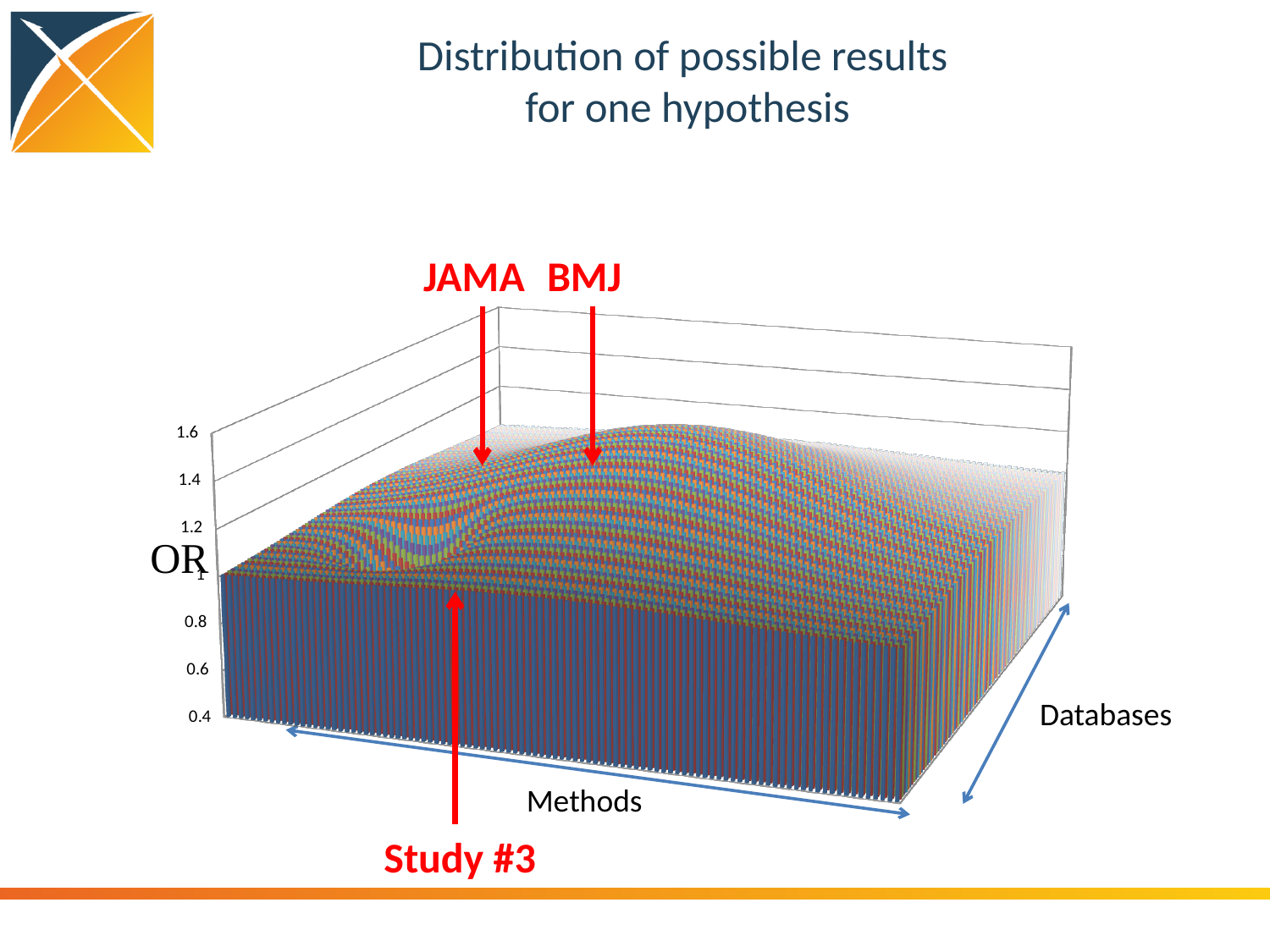
What is the label of the red annotation below the chart? Study #3 What label is given to the vertical axis of the chart? OR What kind of chart is shown on the slide? 3D bar chart Which two journal names are annotated with red arrows above the chart? JAMA and BMJ How many tick values are labelled on the OR axis? 7 What is the lowest tick value shown on the OR axis? 0.4 What is the highest tick value shown on the OR axis? 1.6 What is the title of the chart on the slide? Distribution of possible results for one hypothesis